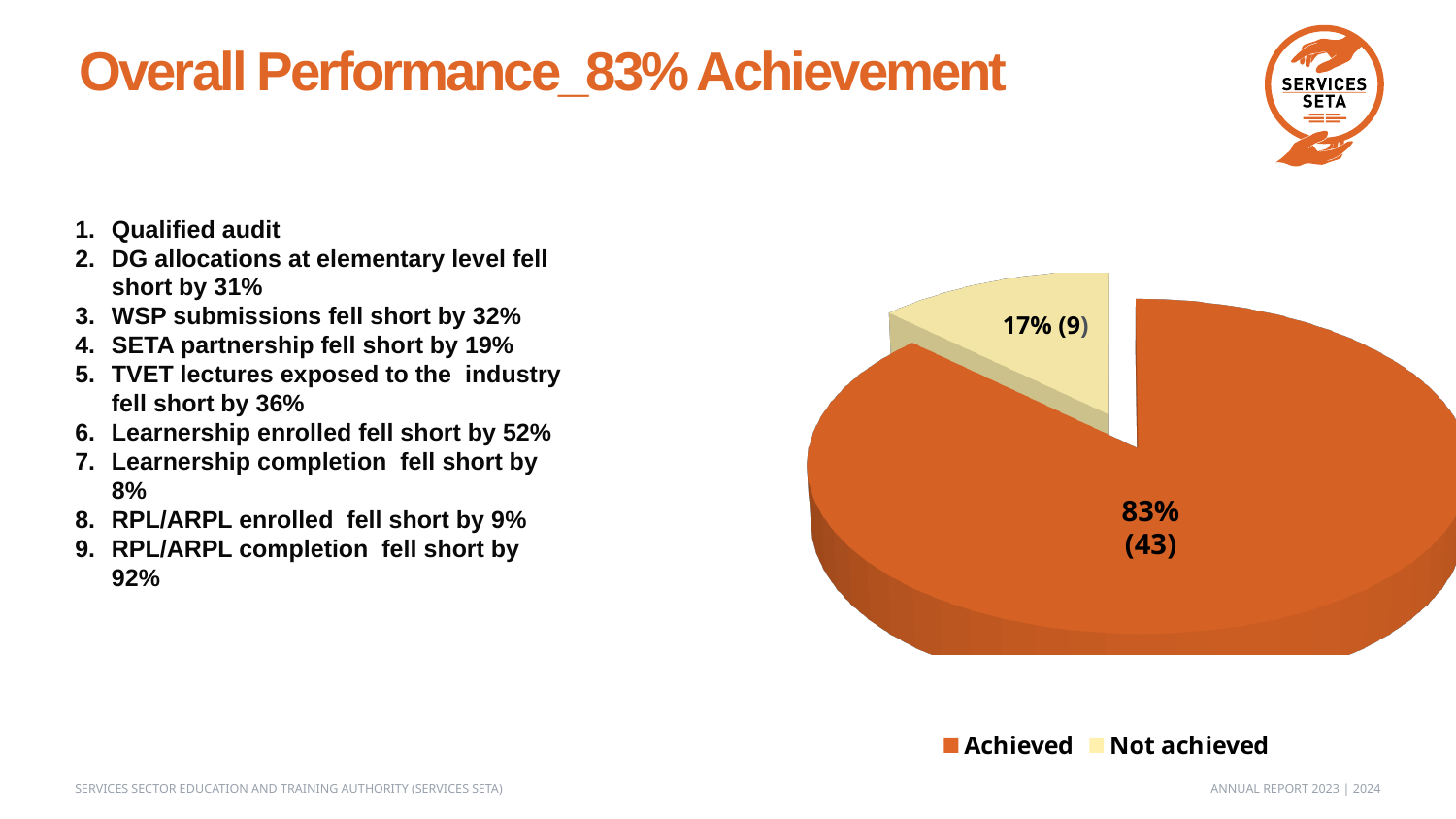
What percentage share does the Achieved slice represent? 83% What is the difference in percentage points between the Achieved and Not achieved slices? 66 Which is larger, the Achieved slice or the Not achieved slice? Achieved What count is shown in the data label for the Not achieved slice? 9 What is the difference between the counts for Achieved (43) and Not achieved (9)? 34 Which slice is the largest in the pie chart? Achieved Which slice is the smallest in the pie chart? Not achieved What count is shown in the data label for the Achieved slice? 43 How many slices does the pie chart have? 2 What colour is the Achieved slice in the pie chart? orange What kind of chart is shown on the slide? pie chart What percentage share does the Not achieved slice represent? 17%